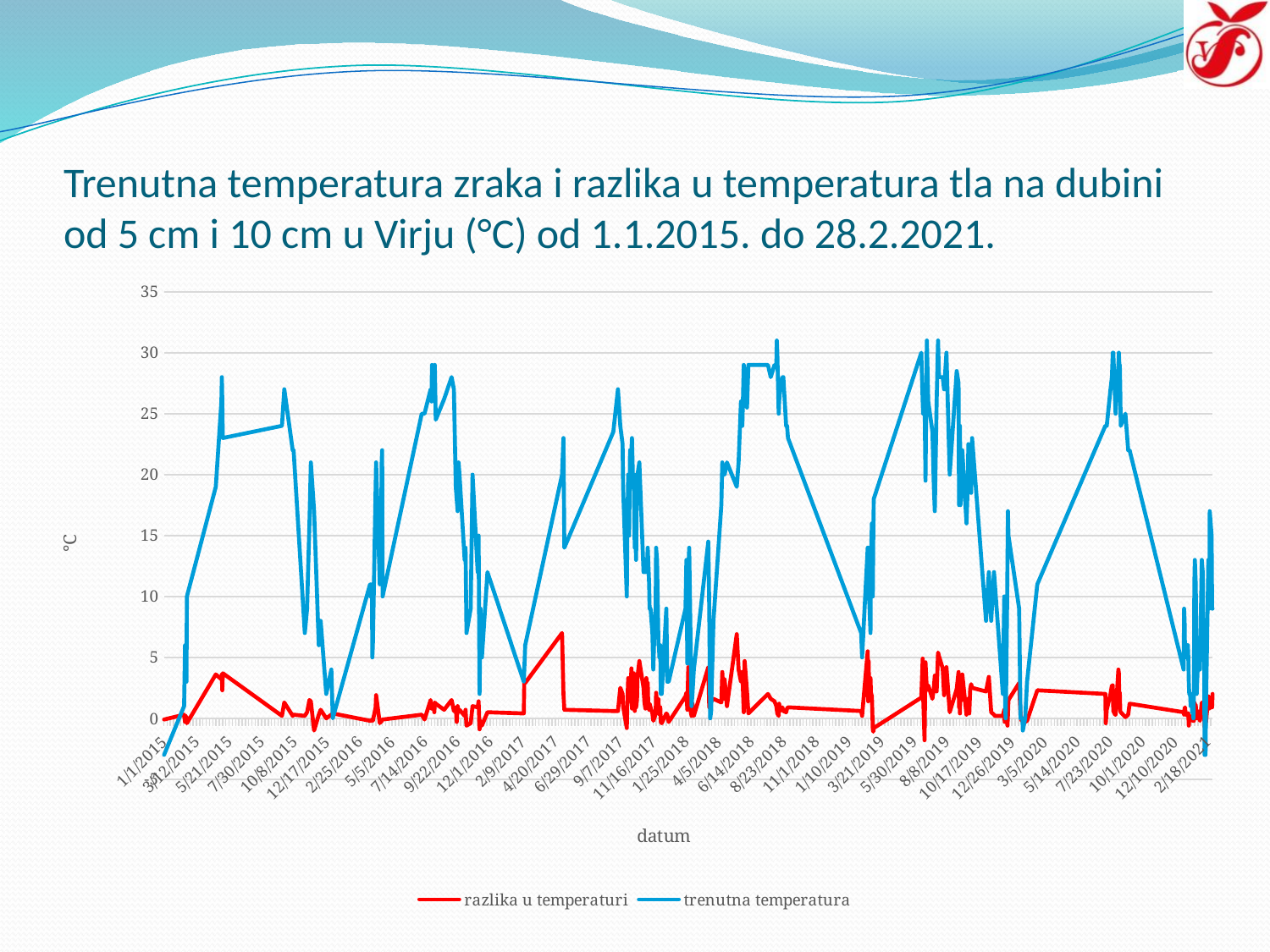
How many series does the legend list? 2 Is the highest value reached by the trenutna temperatura series greater or less than 30? greater Is the highest value reached by the razlika u temperaturi series greater or less than 10? less Is the value of trenutna temperatura at its peak near 8/8/2019 greater or less than 25? greater What is the highest value shown on the vertical axis? 35 Which series reaches higher values on the chart, razlika u temperaturi or trenutna temperatura? trenutna temperatura What kind of chart is shown on the slide? line chart What is the title of the horizontal axis? datum